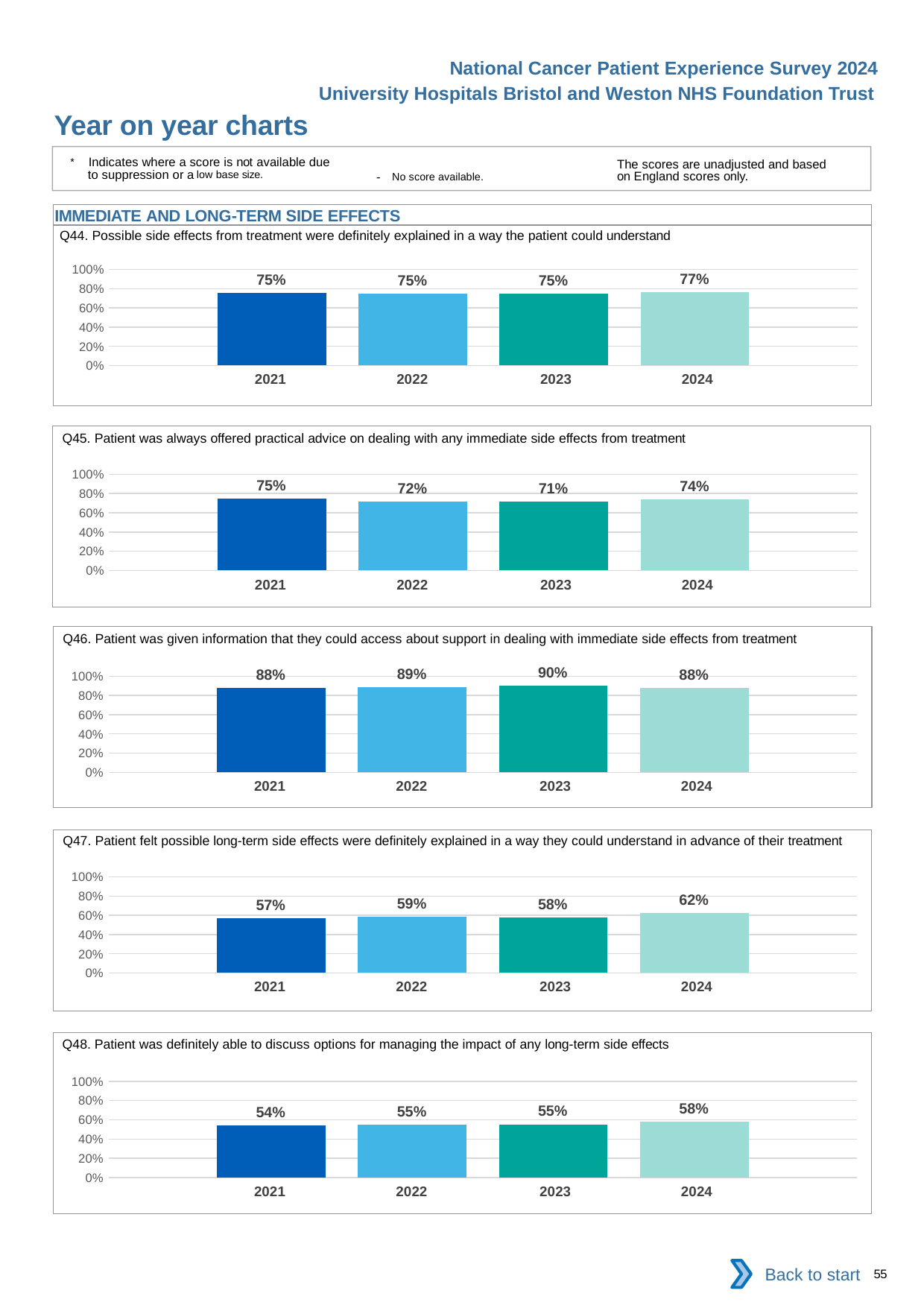
In the Q44 chart, what is the value for 2024? 77% In the Q46 chart, which year has the highest value? 2023 In the Q46 chart, what is the value for 2022? 89% How many years are shown in the Q44 chart? 4 In the Q48 chart, is the value for 2024 greater or less than 60%? less In the Q48 chart, what is the value for 2021? 54% In the Q47 chart, which is larger, the value for 2022 or the value for 2024? 2024 In the Q48 chart, do the values generally rise or fall from 2021 to 2024? rise What kind of chart is the Q46 chart? bar chart In the Q45 chart, what is the difference between the 2021 and 2023 values? 4% In the Q45 chart, which year has the lowest value? 2023 In the Q47 chart, what is the difference between the 2024 and 2021 values? 5%